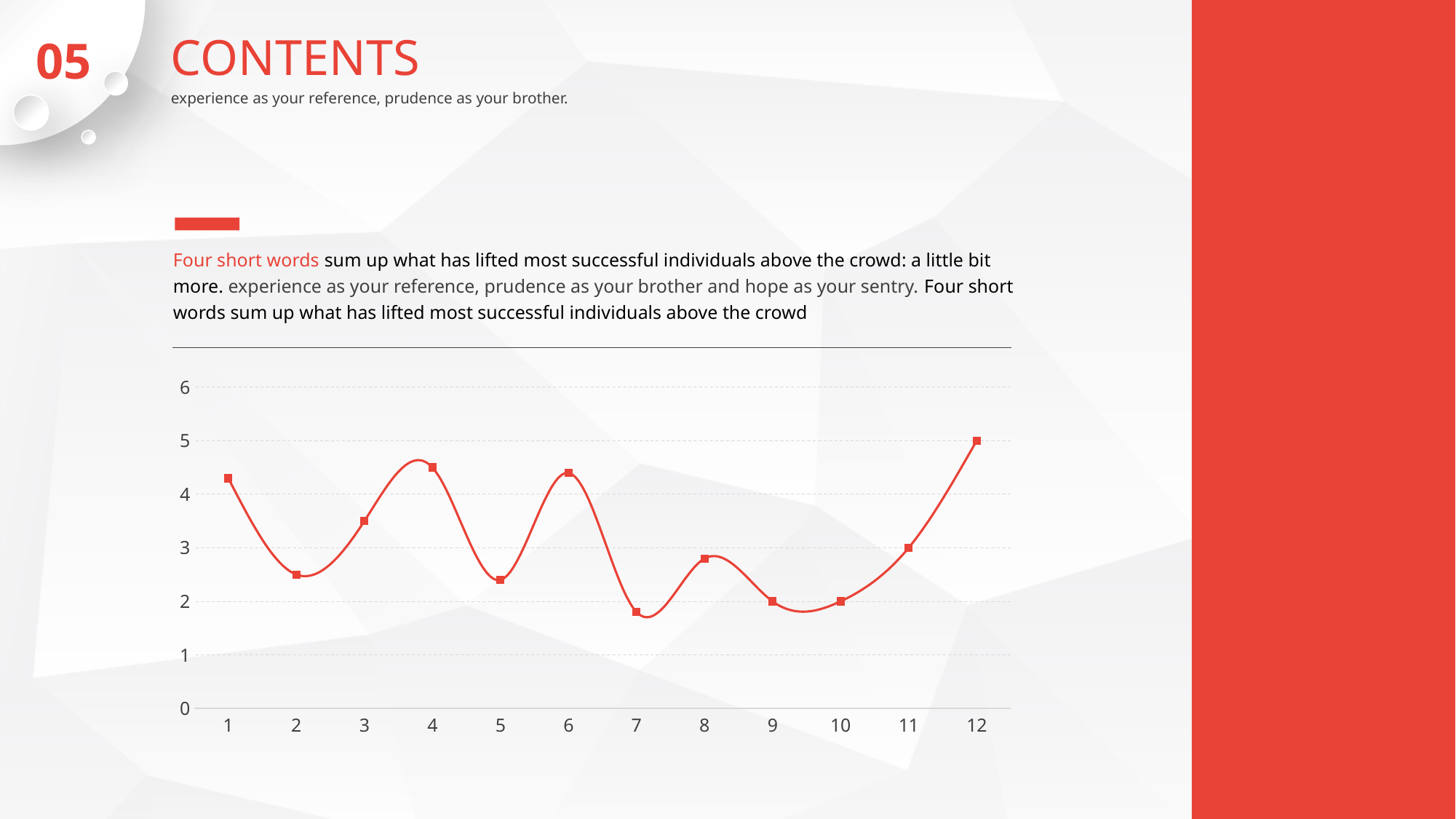
At which x value is the line at its lowest point? 7 Is the value at x = 1 greater or less than 4? greater What is the value at x = 12? 5 How many data points are plotted on the line chart? 12 Is the value at x = 7 greater or less than 2? less What is the value at x = 11? 3 At which x value is the line at its highest point? 12 Does the line rise or fall from x = 9 to x = 12? rise What is the value at x = 10? 2 Is the value at x = 2 greater or less than 3? less Which has the larger value, x = 4 or x = 5? 4 What kind of chart is shown on the slide? line chart